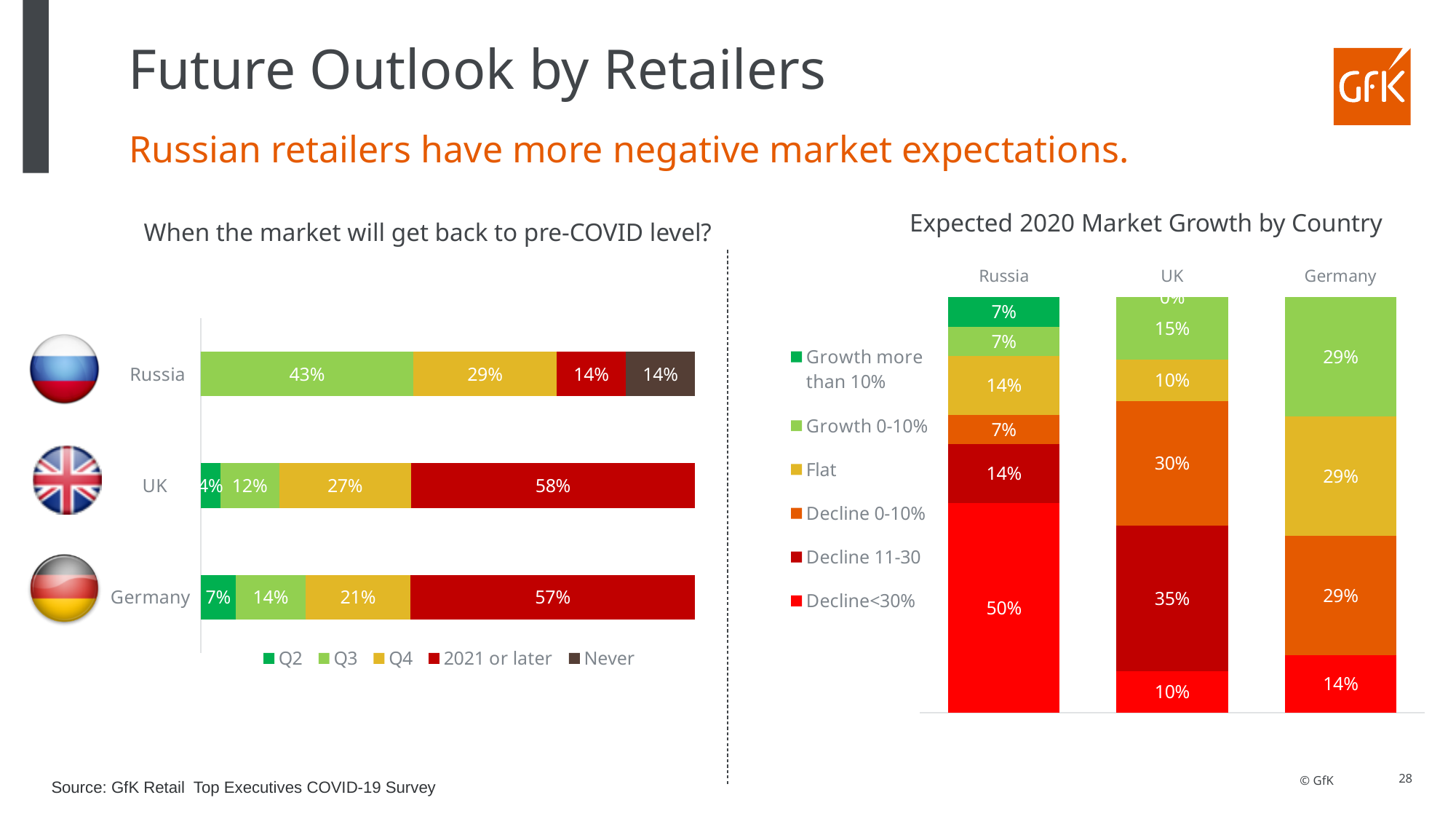
In the chart 'Expected 2020 Market Growth by Country', what share of German retailers expect growth of 0-10%? 29% What type of chart is 'Expected 2020 Market Growth by Country'? Stacked bar chart In the chart 'Expected 2020 Market Growth by Country', what share of Russian retailers expect a decline of more than 30%? 50% In the chart 'When the market will get back to pre-COVID level?', what share of Russian retailers expect recovery in Q3? 43% In the chart 'Expected 2020 Market Growth by Country', what share of UK retailers expect a decline of 11-30? 35% In the chart 'When the market will get back to pre-COVID level?', how many entries does the legend list? 5 In the chart 'Expected 2020 Market Growth by Country', how many countries are shown? 3 In the chart 'Expected 2020 Market Growth by Country', which country has the highest share of retailers expecting a decline of more than 30%? Russia In the chart 'When the market will get back to pre-COVID level?', what share of UK retailers expect recovery in 2021 or later? 58% In the chart 'When the market will get back to pre-COVID level?', which is larger: the Q2 share for UK or for Germany? Germany In the chart 'When the market will get back to pre-COVID level?', what is the difference between the Q4 shares for Russia and Germany? 8% In the chart 'When the market will get back to pre-COVID level?', which country has the largest share of retailers answering 'Never'? Russia